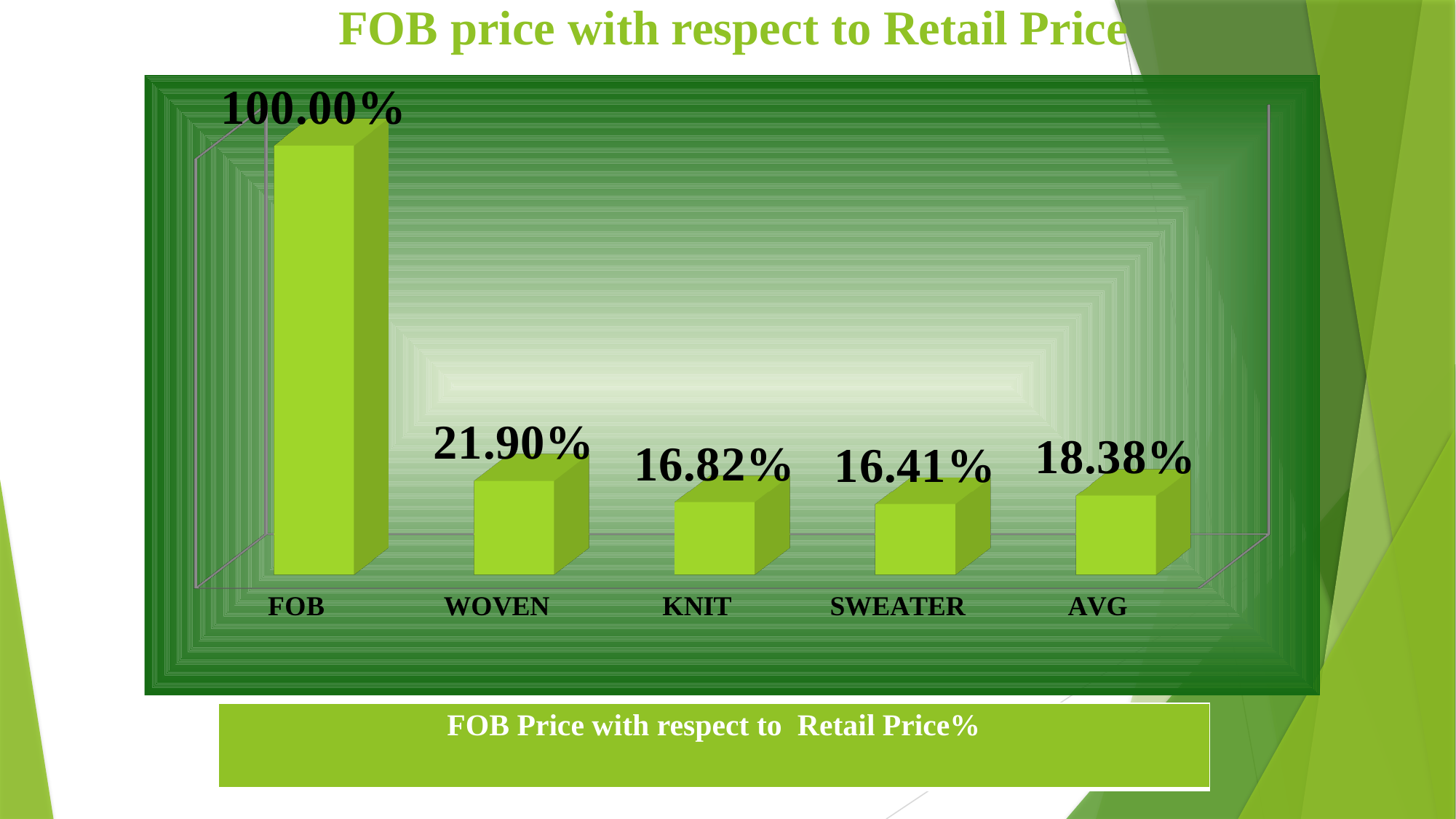
Which category has the highest value? FOB Which category has the lowest value? SWEATER What is the value for SWEATER? 16.41% What is the value for WOVEN? 21.90% Which is larger, the value for WOVEN or the value for AVG? WOVEN What kind of chart is shown on the slide? bar chart How many categories are shown on the x axis? 5 What is the value for AVG? 18.38% What is the title of the chart? FOB price with respect to Retail Price What is the difference between the values for FOB and AVG? 81.62% What is the value for KNIT? 16.82% What is the difference between the values for WOVEN and KNIT? 5.08%